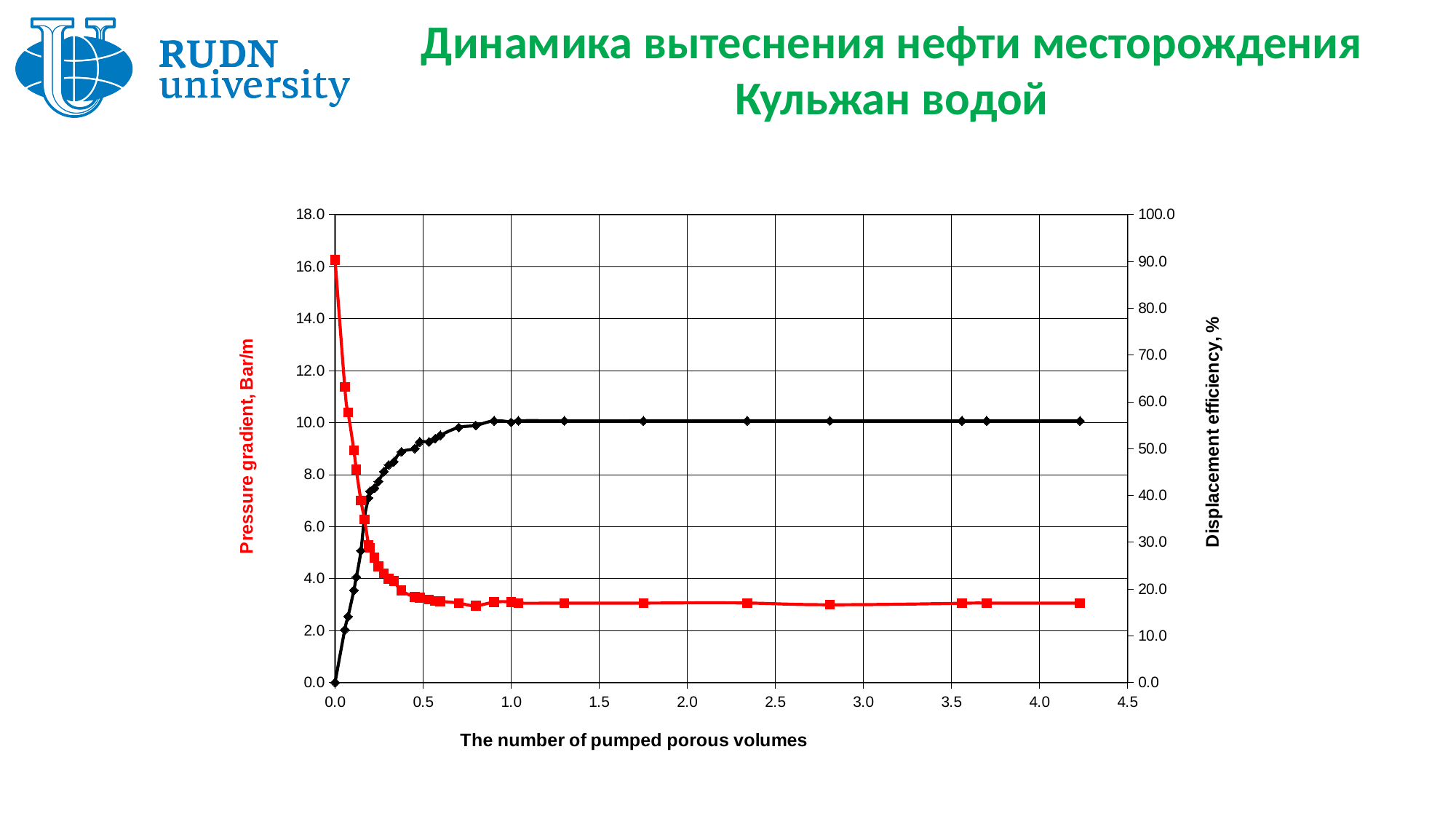
Is the displacement efficiency at 0.5 pumped porous volumes greater or less than 40.0%? greater Is the pressure gradient at 0.0 pumped porous volumes greater or less than 14.0 Bar/m? greater What is the maximum value shown on the left vertical axis (pressure gradient)? 18.0 Does the red series (pressure gradient) rise or fall as the number of pumped porous volumes increases? Falls What kind of chart is shown on the slide? Line chart Is the displacement efficiency at 4.2 pumped porous volumes greater or less than 50.0%? greater At which number of pumped porous volumes is the pressure gradient highest? 0.0 What is the title of the right-hand vertical axis of the chart? Displacement efficiency, % What is the displacement efficiency at 0.0 pumped porous volumes? 0.0 Does the black series (displacement efficiency) rise or fall as the number of pumped porous volumes increases? Rises What is the title of the x axis of the chart? The number of pumped porous volumes